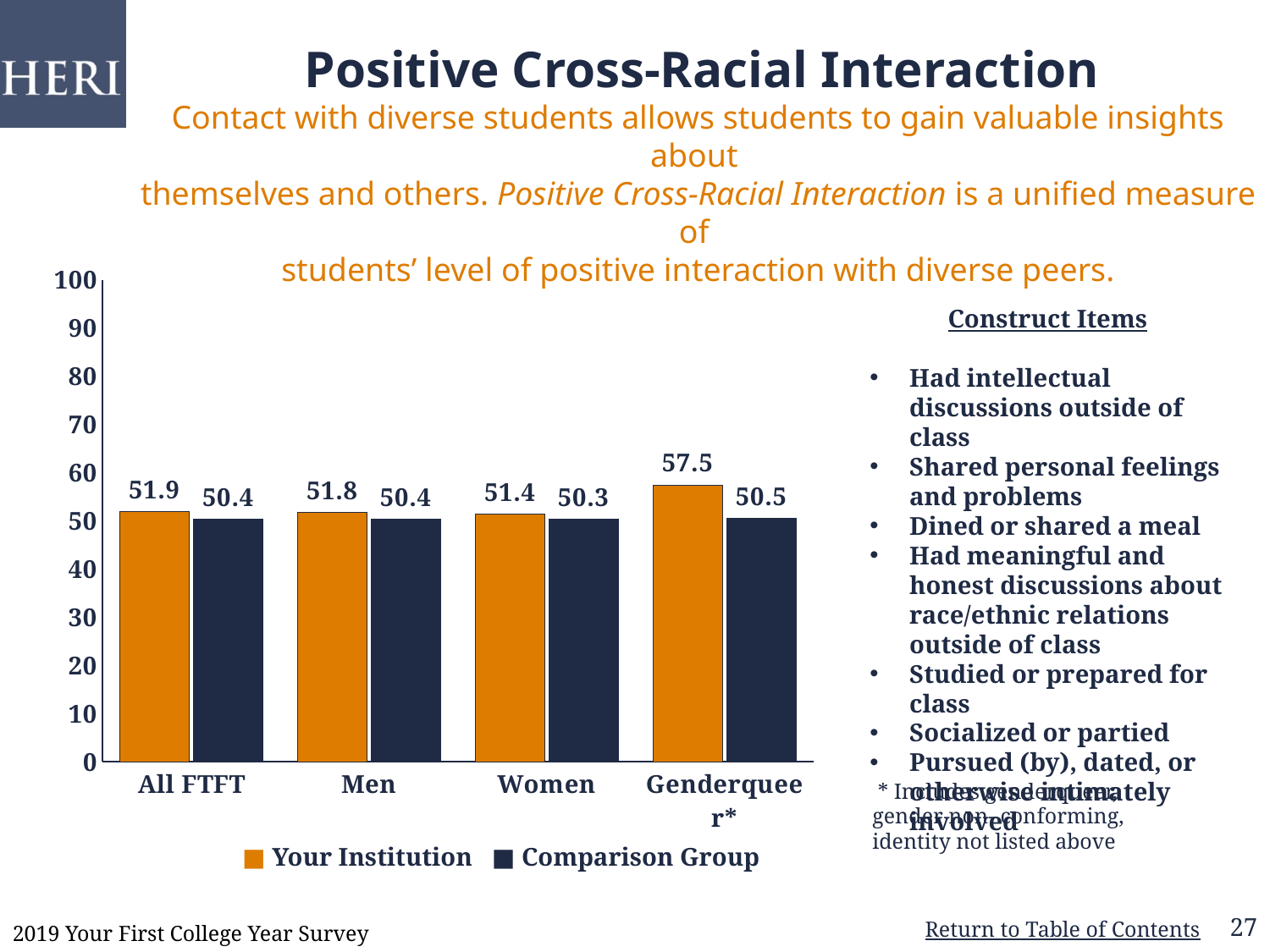
Which category has the lowest value for Your Institution? Women What is the value for Your Institution in the Genderqueer* category? 57.5 How many categories are shown on the x axis? 4 How many series does the legend list? 2 Which is larger in the Men category: Your Institution or Comparison Group? Your Institution What is the difference between Your Institution and Comparison Group in the Genderqueer* category? 7.0 What kind of chart is shown on the slide? Bar chart Which category has the highest value for Your Institution? Genderqueer* What is the value for Comparison Group in the Men category? 50.4 What colour represents the Comparison Group series? Dark navy blue What is the value for Your Institution in the All FTFT category? 51.9 What is the value for Comparison Group in the Women category? 50.3